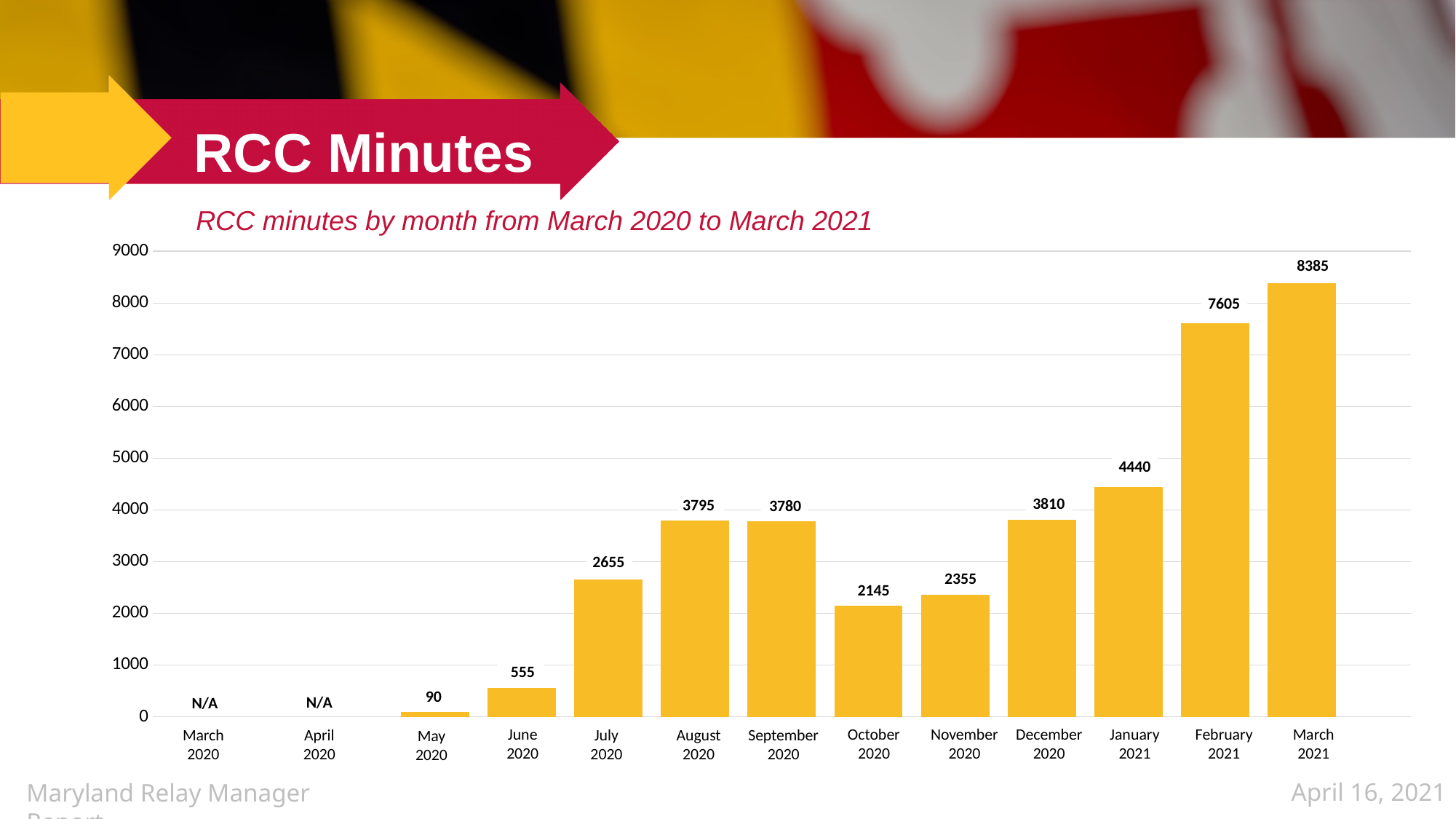
How many months are shown on the x axis? 13 What is the value for August 2020? 3795 Which is larger, the value for July 2020 or the value for November 2020? July 2020 What is the subtitle of the chart? RCC minutes by month from March 2020 to March 2021 Is the value for February 2021 greater or less than 7000? greater What kind of chart is shown on the slide? bar chart What is the value shown for March 2020? N/A What is the value for January 2021? 4440 What is the difference between March 2021 and February 2021? 780 Which month has the highest value? March 2021 Which month with a numeric value has the lowest value? May 2020 What is the difference between December 2020 and October 2020? 1665